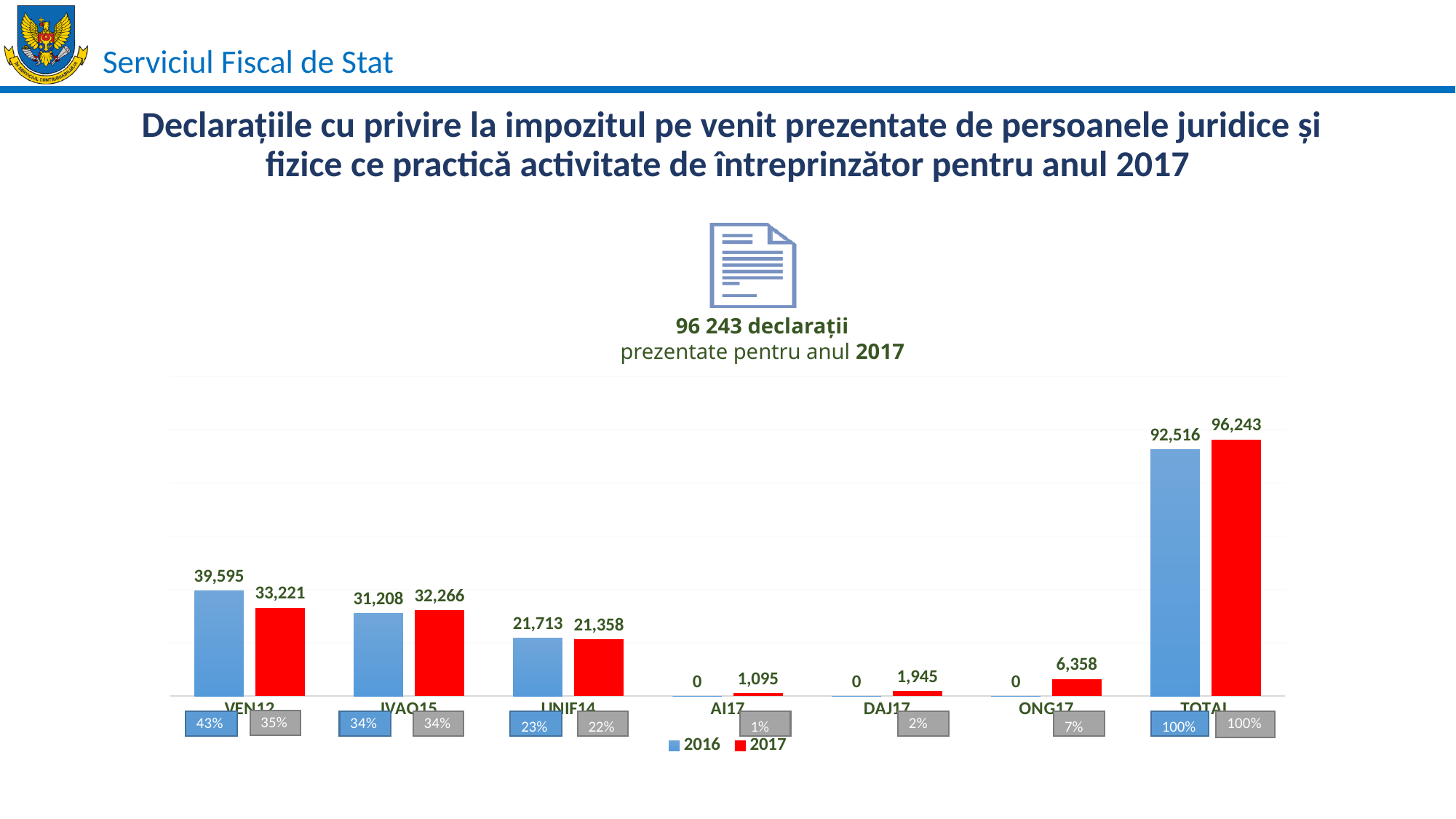
Excluding TOTAL, which category has the lowest 2017 value? AI17 Which is larger for UNIF14, the 2016 value or the 2017 value? 2016 How many series does the legend list? 2 What is the 2017 value for VEN12? 33,221 What kind of chart is shown on the slide? Bar chart What is the 2016 value for TOTAL? 92,516 Excluding TOTAL, which category has the highest 2016 value? VEN12 What is the 2016 value for IVAO15? 31,208 What is the 2017 value for ONG17? 6,358 What is the difference between the 2017 and 2016 values for TOTAL? 3,727 Which colour represents the 2017 series in the chart? Red How many categories are shown on the x axis? 7